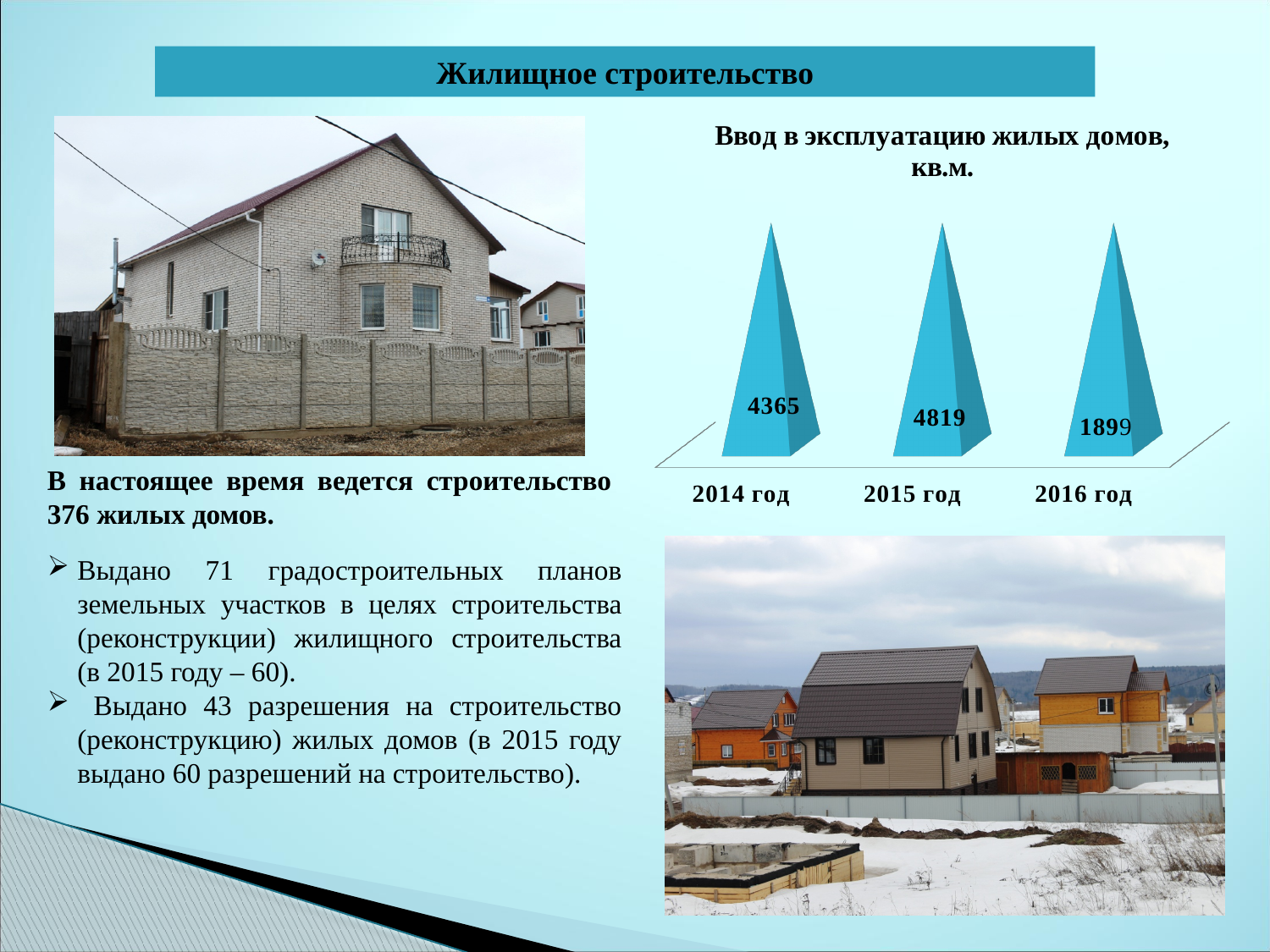
What is the difference between the values for 2015 год and 2014 год in the chart 'Ввод в эксплуатацию жилых домов, кв.м.'? 454 What is the difference between the values for 2015 год and 2016 год in the chart 'Ввод в эксплуатацию жилых домов, кв.м.'? 2920 In the chart 'Ввод в эксплуатацию жилых домов, кв.м.', which is larger: the value for 2014 год or 2016 год? 2014 год What is the value for 2014 год in the chart 'Ввод в эксплуатацию жилых домов, кв.м.'? 4365 What is the value for 2016 год in the chart 'Ввод в эксплуатацию жилых домов, кв.м.'? 1899 What kind of chart is 'Ввод в эксплуатацию жилых домов, кв.м.'? bar chart How many years are shown in the chart 'Ввод в эксплуатацию жилых домов, кв.м.'? 3 Which year has the highest value in the chart 'Ввод в эксплуатацию жилых домов, кв.м.'? 2015 год Which year has the lowest value in the chart 'Ввод в эксплуатацию жилых домов, кв.м.'? 2016 год What is the value for 2015 год in the chart 'Ввод в эксплуатацию жилых домов, кв.м.'? 4819 In the chart 'Ввод в эксплуатацию жилых домов, кв.м.', does the value rise or fall from 2015 год to 2016 год? fall What is the title of the chart on the slide? Ввод в эксплуатацию жилых домов, кв.м.